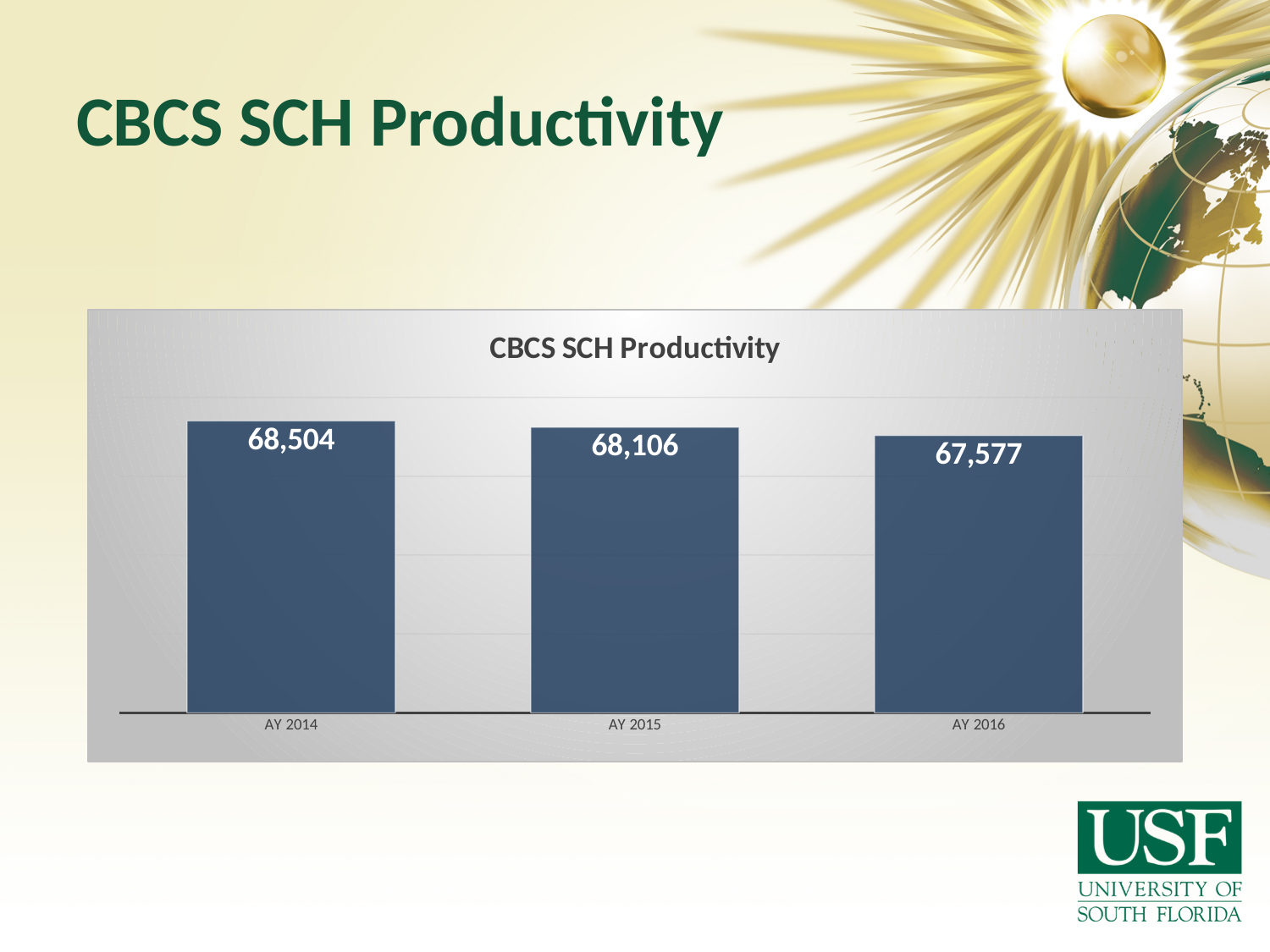
Which is larger, the value for AY 2015 or the value for AY 2016? AY 2015 What is the CBCS SCH Productivity value for AY 2015? 68,106 Which academic year has the lowest CBCS SCH Productivity? AY 2016 What is the CBCS SCH Productivity value for AY 2016? 67,577 What is the difference between the AY 2014 and AY 2016 values? 927 What is the difference between the AY 2014 and AY 2015 values? 398 Do the values rise or fall from AY 2014 to AY 2016? Fall What is the difference between the AY 2015 and AY 2016 values? 529 Which academic year has the highest CBCS SCH Productivity? AY 2014 How many academic years are shown in the chart? 3 What kind of chart is shown on the slide? Bar chart What is the CBCS SCH Productivity value for AY 2014? 68,504